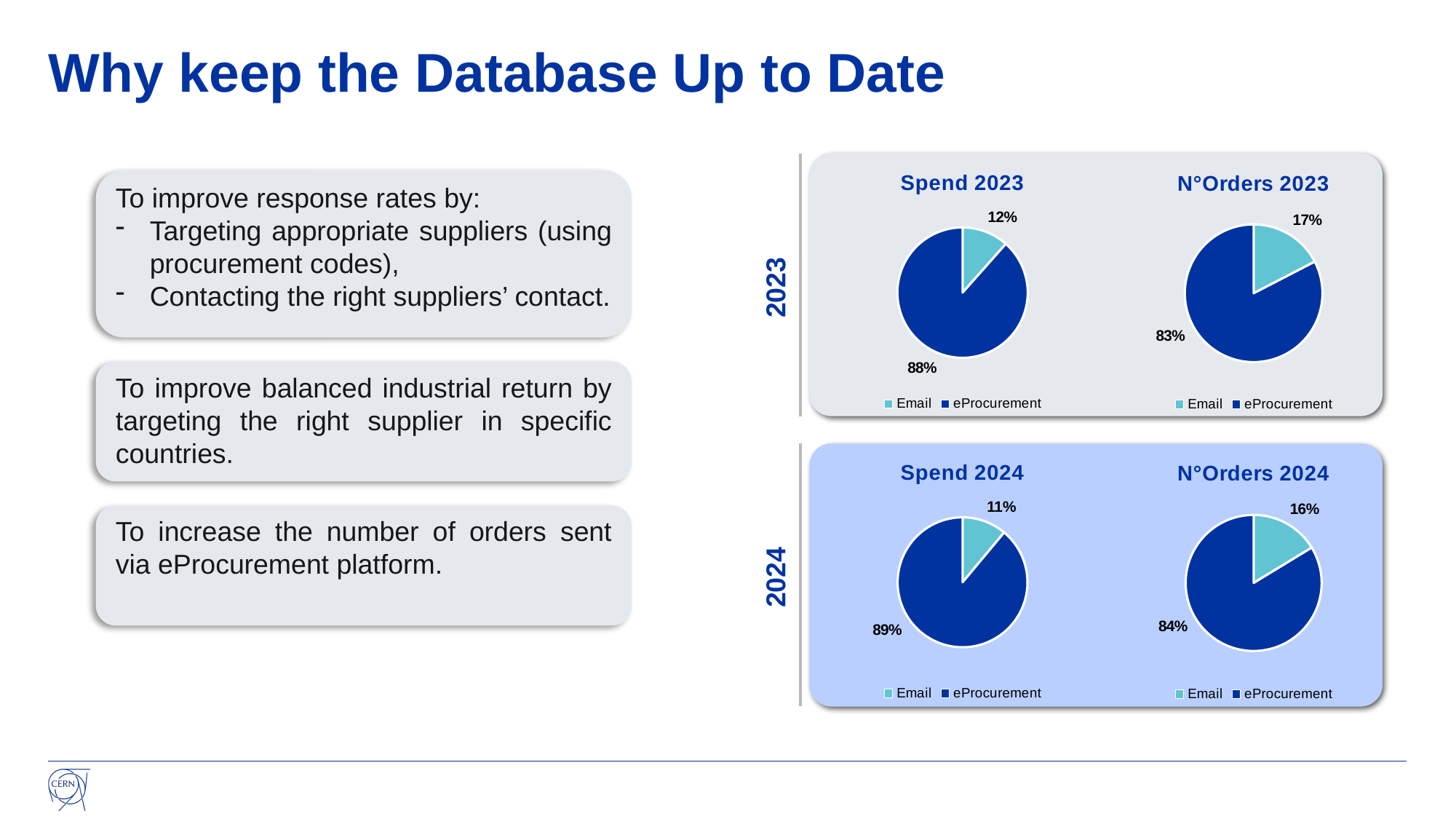
In the 'N°Orders 2023' chart, what is the difference between the eProcurement and Email shares? 66% In the 'N°Orders 2024' chart, which slice is the smallest? Email In the 'Spend 2023' chart, what share of spend is eProcurement? 88% In the 'N°Orders 2023' chart, what share of orders is eProcurement? 83% In the 'Spend 2024' chart, which slice is the largest? eProcurement In the 'Spend 2024' chart, what share of spend is Email? 11% In the 'Spend 2023' chart, what share of spend is Email? 12% In the 'N°Orders 2024' chart, what share of orders is eProcurement? 84% Is the Email share larger in the 'N°Orders 2023' chart or the 'Spend 2023' chart? N°Orders 2023 What kind of chart is 'Spend 2024'? Pie chart How many series does the legend of the 'N°Orders 2024' chart list? 2 In the 'N°Orders 2023' chart, what share of orders is Email? 17%